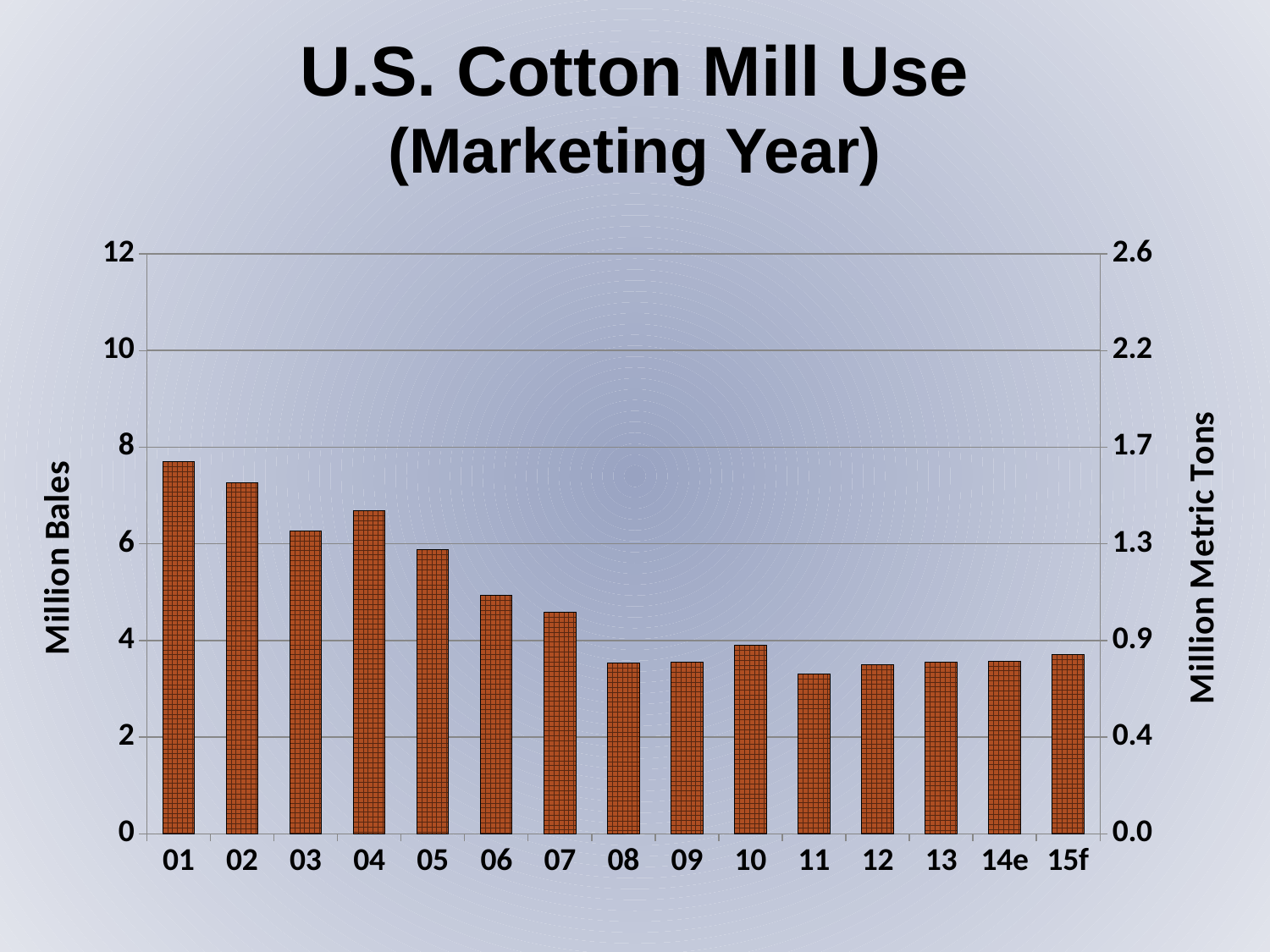
Is the value for 15f greater or less than 4 million bales? less How many marketing years are plotted on the chart? 15 Which has the larger cotton mill use, 03 or 04? 04 Which marketing year has the highest cotton mill use? 01 What kind of chart is shown on the slide? bar chart Is the value for 01 greater or less than 6 million bales? greater Which has the larger cotton mill use, 10 or 11? 10 What is the label on the left vertical axis? Million Bales Is the value for 08 greater or less than 4 million bales? less Which marketing year has the lowest cotton mill use? 11 Overall, do the values rise or fall from 01 to 15f? fall